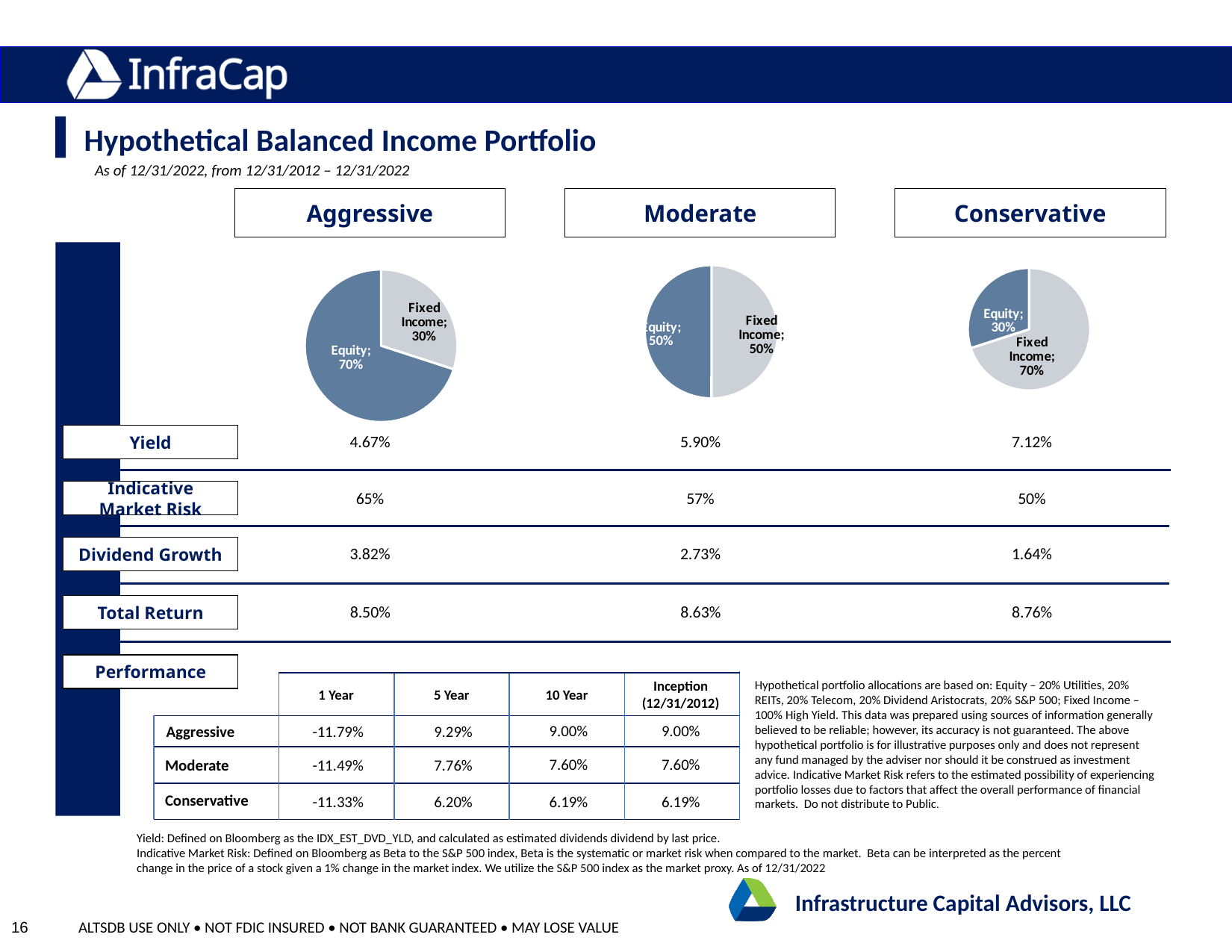
In the Conservative pie chart, what share is Fixed Income? 70% How many pie charts are shown on the slide? 3 What type of chart is used to show the Moderate portfolio allocation? pie chart In the Moderate pie chart, what share is Fixed Income? 50% In the Aggressive pie chart, what share is Fixed Income? 30% In the Aggressive pie chart, what is the difference between the Equity and Fixed Income shares? 40% In the Conservative pie chart, is the Fixed Income slice larger or smaller than the Equity slice? larger In the Aggressive pie chart, what share is Equity? 70% In the Conservative pie chart, what share is Equity? 30% In the Conservative pie chart, which slice is the smallest? Equity How many slices does the Moderate pie chart have? 2 In the Aggressive pie chart, which slice is the largest? Equity